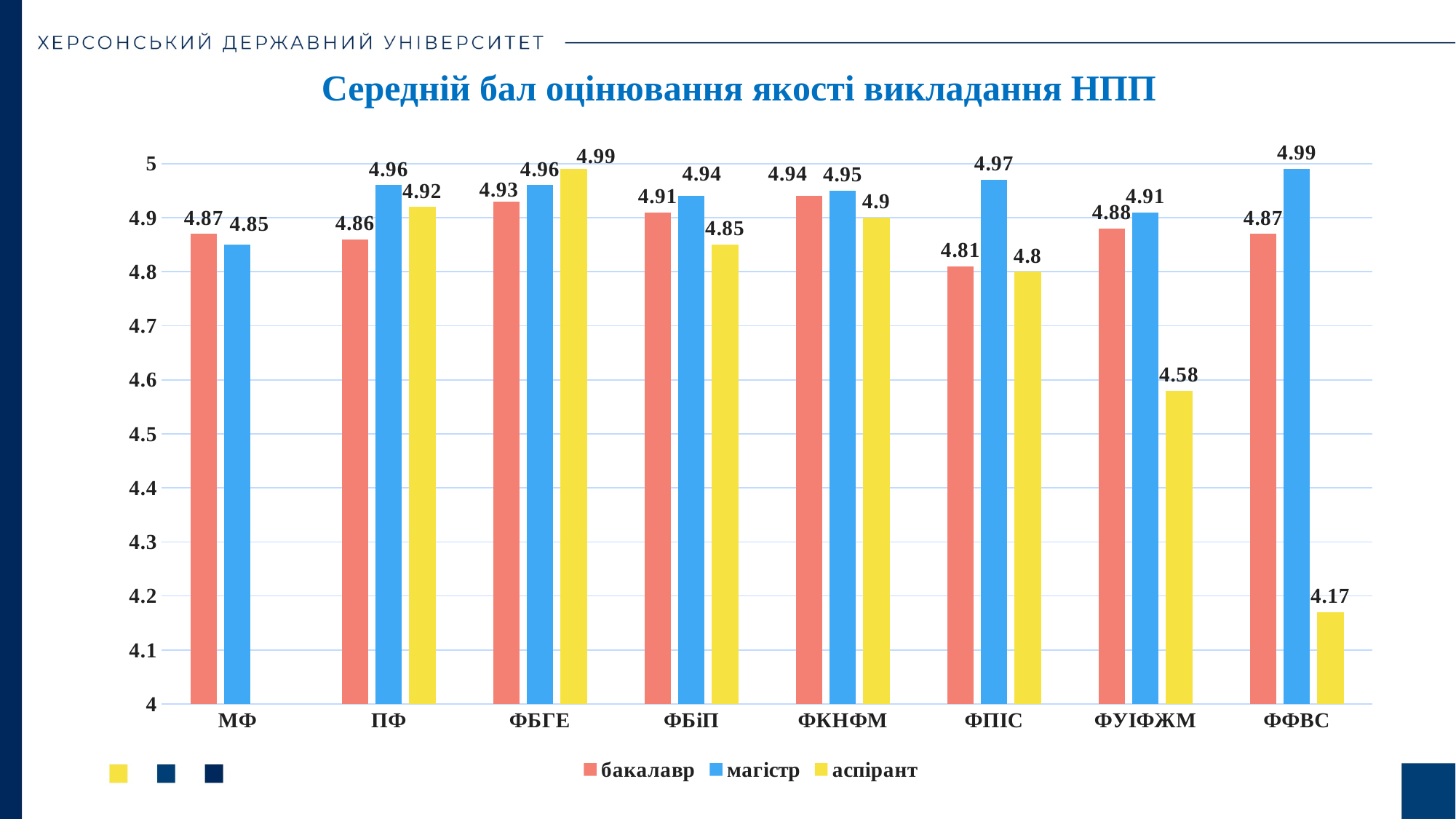
Which category has the lowest аспірант value? ФФВС How many categories are shown on the x axis? 8 What is the value for аспірант at ФУІФЖМ? 4.58 What is the value for магістр at ФПІС? 4.97 At ПФ, which is larger: the бакалавр value or the магістр value? магістр Which category has the highest магістр value? ФФВС How many series does the legend list? 3 What kind of chart is shown on the slide? bar chart Is the аспірант value for ФУІФЖМ greater or less than 4.5? greater What is the title of the chart? Середній бал оцінювання якості викладання НПП What is the difference between the магістр and аспірант values at ФФВС? 0.82 What is the value for бакалавр at ФБіП? 4.91